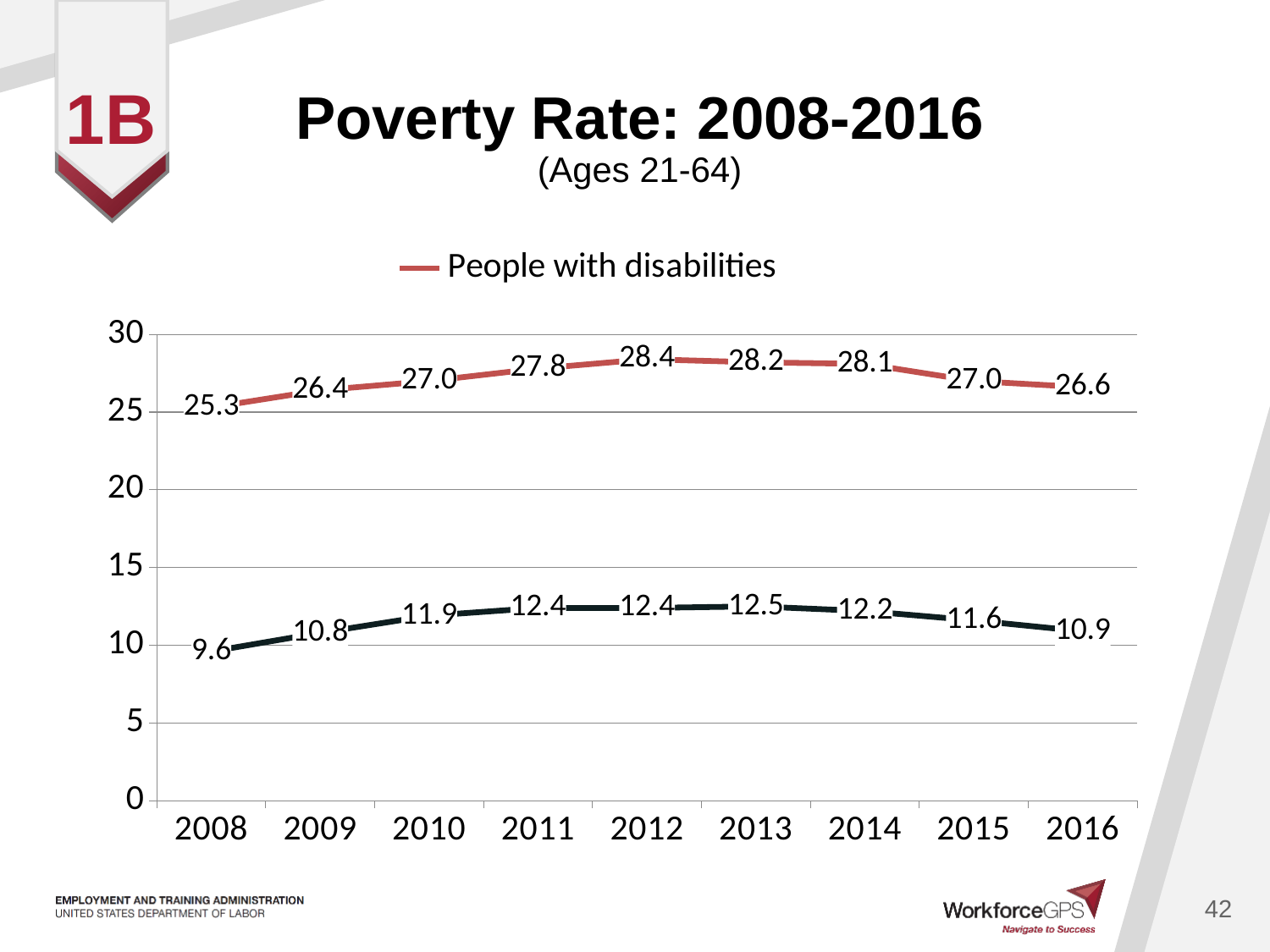
How many series does the chart's legend list? 1 What is the difference between the People with disabilities poverty rate in 2012 and in 2008? 3.1 Is the 2011 value for People with disabilities greater or less than 25? greater What is the title of the chart on the slide? Poverty Rate: 2008-2016 In which year is the poverty rate for People with disabilities lowest? 2008 Does the poverty rate for People with disabilities rise or fall from 2008 to 2012? rise What kind of chart is shown on the slide? line chart In which year is the poverty rate for People with disabilities highest? 2012 How many years are shown on the x axis of the chart? 9 What is the poverty rate for People with disabilities in 2012? 28.4 Which year has the higher poverty rate for People with disabilities, 2009 or 2016? 2016 What is the poverty rate for People with disabilities in 2008? 25.3